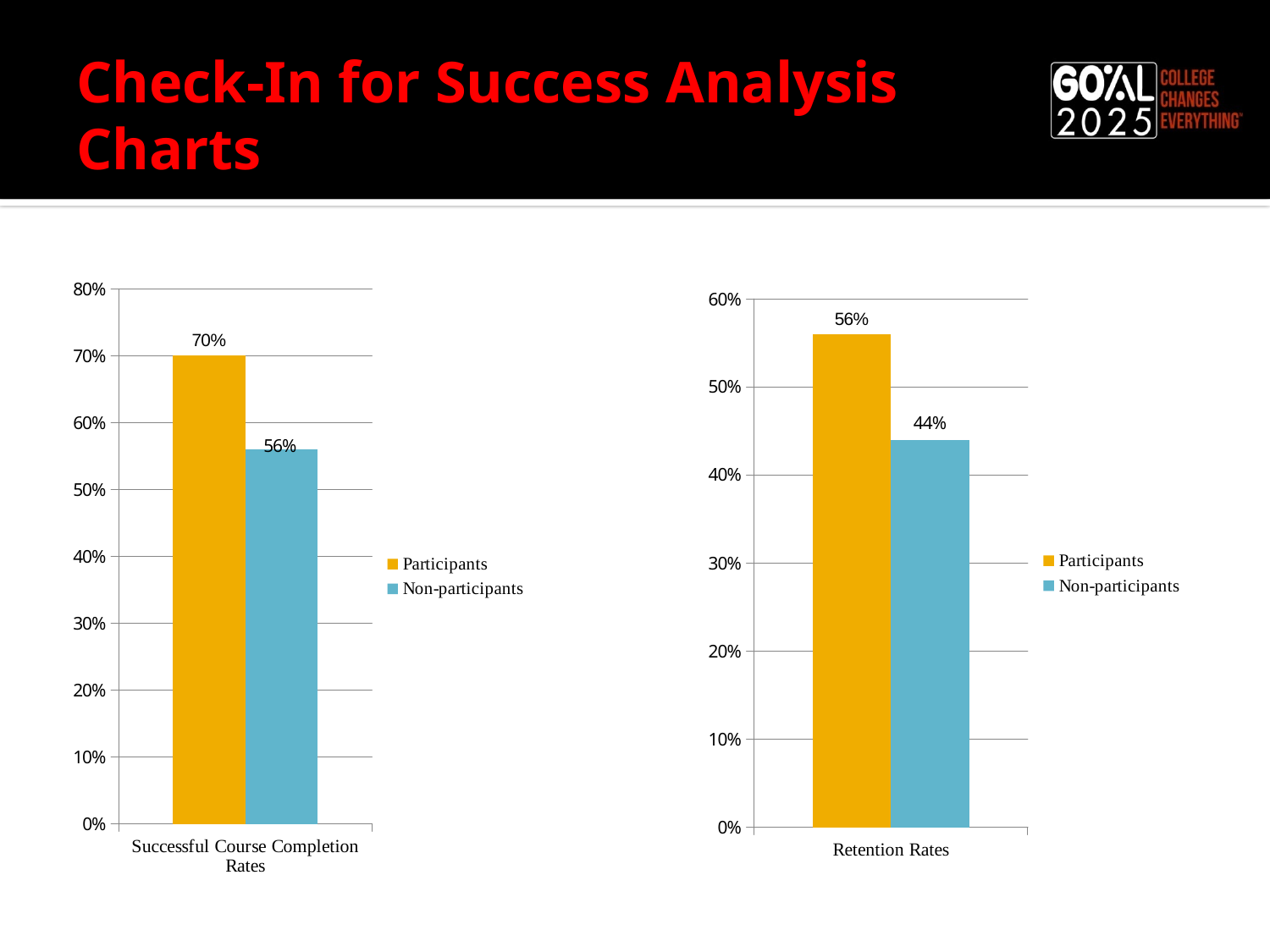
In the right chart (Retention Rates), which series has the higher value, Participants or Non-participants? Participants In the right chart (Retention Rates), what is the value for Participants? 56% In the left chart (Successful Course Completion Rates), what is the value for Non-participants? 56% In the right chart (Retention Rates), is the value for Non-participants greater or less than 50%? less In the left chart (Successful Course Completion Rates), what is the value for Participants? 70% In the left chart (Successful Course Completion Rates), what is the difference between the Participants and Non-participants values? 14% In the right chart (Retention Rates), what is the difference between the Participants and Non-participants values? 12% In the left chart (Successful Course Completion Rates), which series has the lowest value? Non-participants In the right chart (Retention Rates), what is the value for Non-participants? 44% How many series does the legend of the left chart (Successful Course Completion Rates) list? 2 In the left chart, what colour are the Participants bars? Orange What kind of chart is the right chart (Retention Rates)? Bar chart